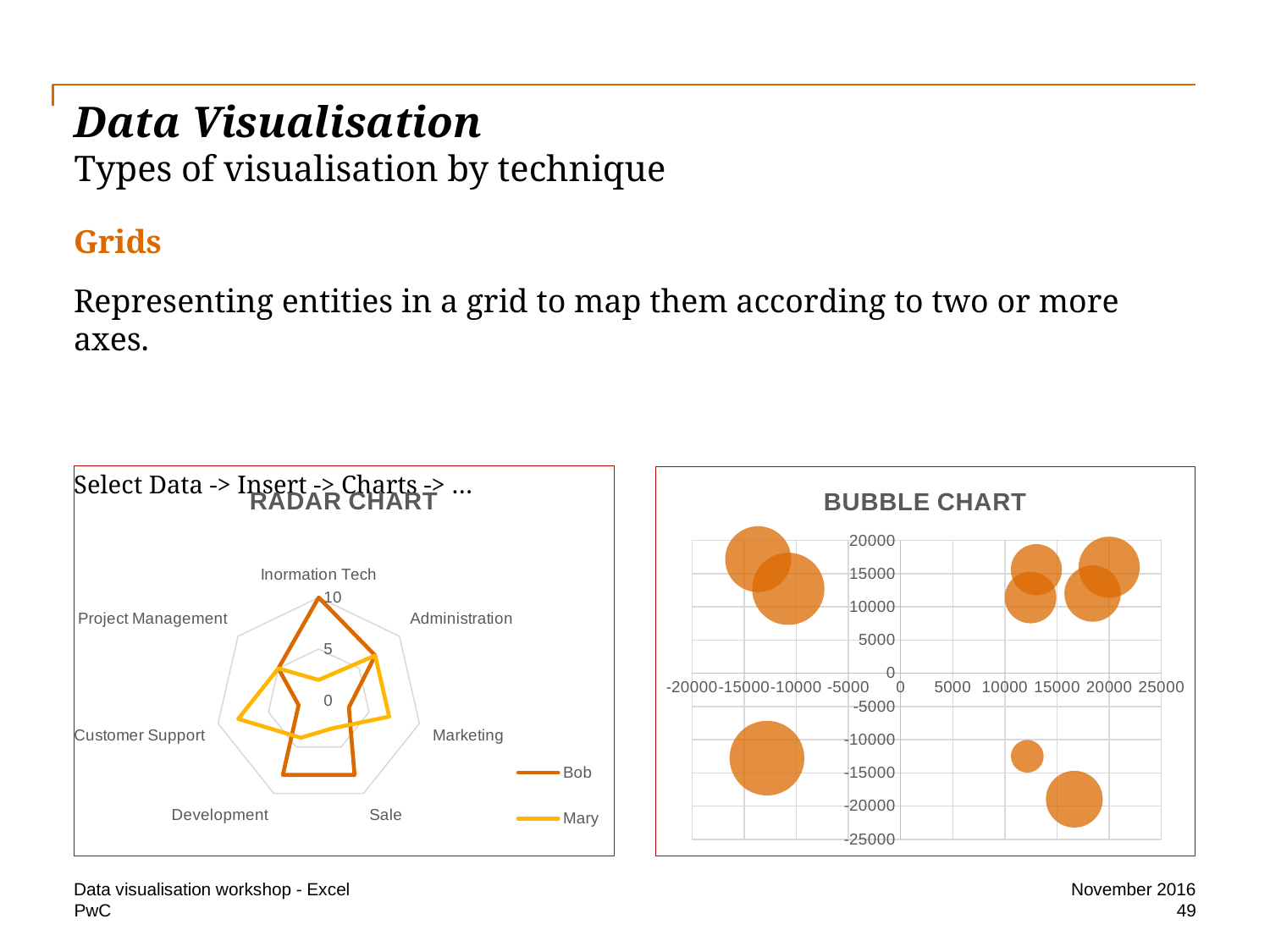
On the bubble chart, is the y value of the lowest bubble (bottom right) greater or less than -15000? less On the radar chart, is Mary's value for Customer Support greater or less than 5? greater What kind of chart is the chart on the right of the slide? Bubble chart On the radar chart, which category has Bob's highest value? Inormation Tech On the radar chart, who has the larger value for Customer Support, Bob or Mary? Mary On the radar chart, is Bob's value for Customer Support greater or less than 5? less On the radar chart, what are the names of the two series in the legend? Bob and Mary On the bubble chart, how many bubbles are plotted? 9 On the radar chart, which category has Mary's highest value? Customer Support On the radar chart, how many series does the legend list? 2 On the radar chart, how many categories are plotted around the axis? 7 On the radar chart, who has the larger value for Development, Bob or Mary? Bob